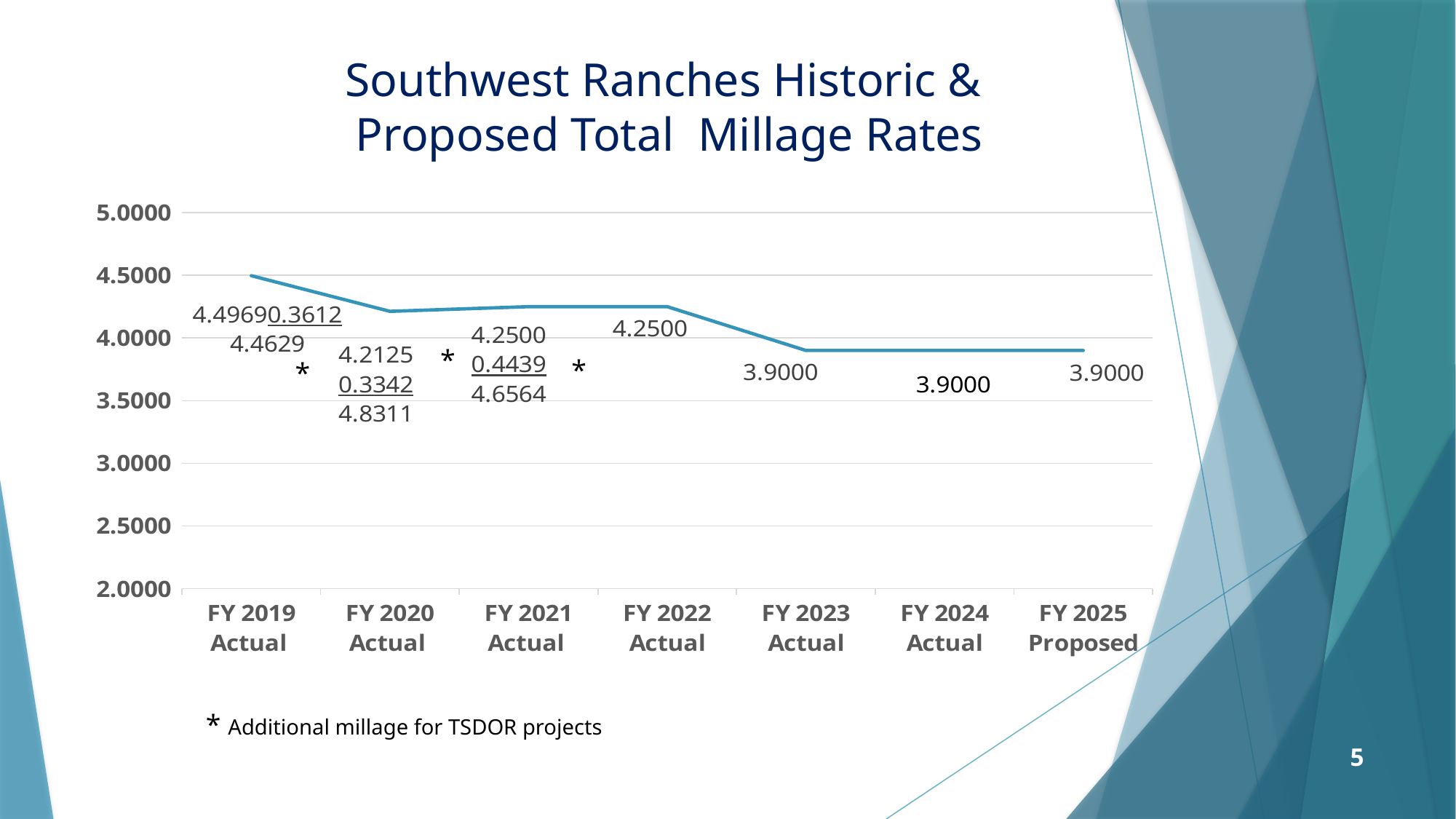
Is the millage rate for FY 2019 Actual greater or less than 4.0000? greater What is the total millage rate for FY 2022 Actual? 4.2500 What is the total millage rate for FY 2023 Actual? 3.9000 How many fiscal years are plotted on the x axis? 7 Which fiscal year has the highest total millage rate? FY 2019 Actual What is the difference between the FY 2022 Actual and FY 2023 Actual millage rates? 0.3500 What kind of chart is shown on the slide? line chart Do the millage rates generally rise or fall from FY 2019 to FY 2025? fall What is the lowest total millage rate shown on the chart? 3.9000 What is the total millage rate for FY 2020 Actual? 4.2125 What is the total millage rate for FY 2025 Proposed? 3.9000 Which is larger, the millage rate for FY 2020 Actual or FY 2021 Actual? FY 2021 Actual